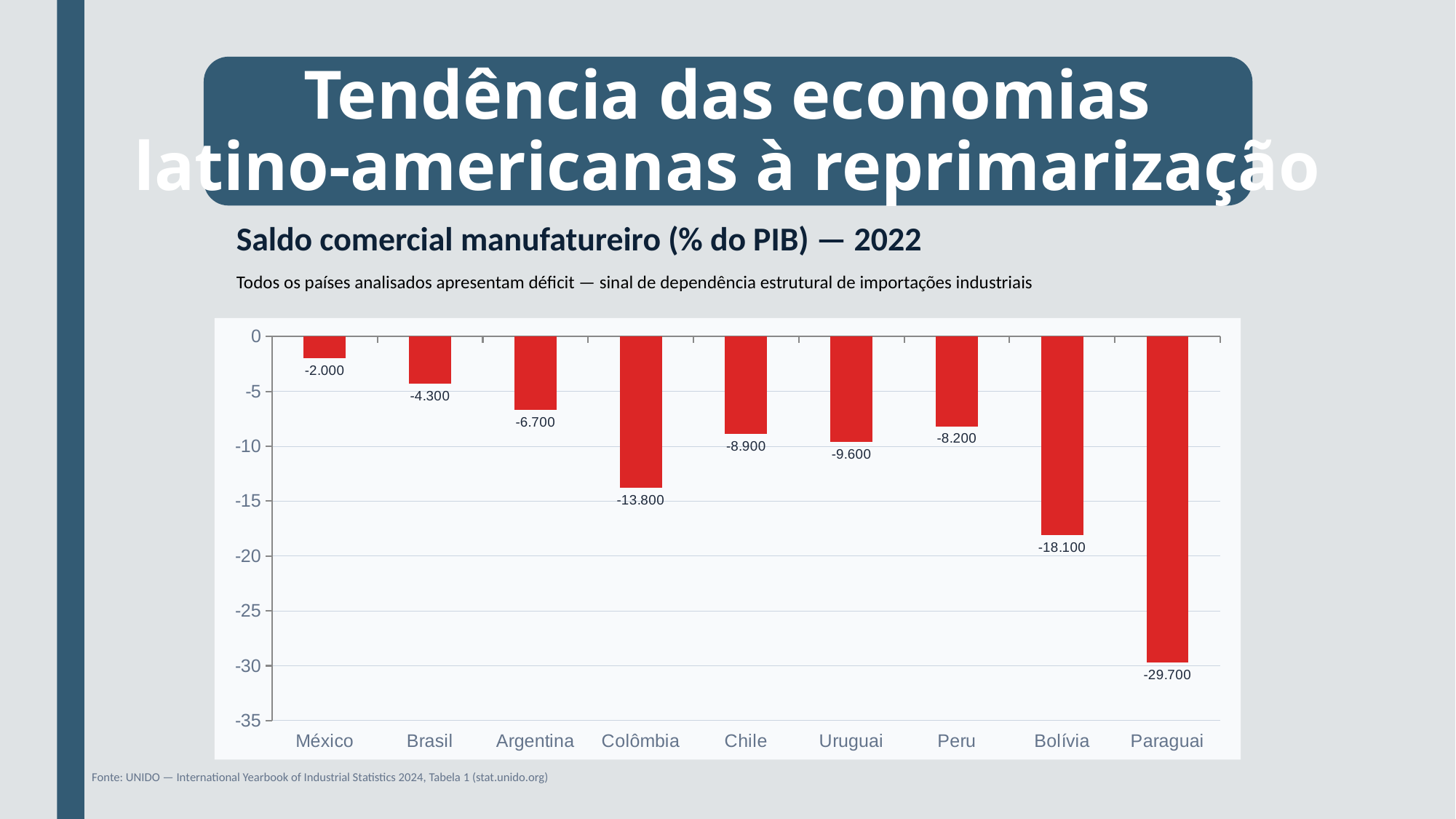
Which country has the highest value (smallest deficit)? México What is the value for Paraguai? -29.700 Which country has the lowest (most negative) value? Paraguai What is the difference between the values for Bolívia and Paraguai? 11.600 What kind of chart is shown on the slide? bar chart Is the value for Bolívia greater or less than -15? less What is the value for Uruguai? -9.600 What is the value for Colômbia? -13.800 Which has the larger deficit, Chile or Peru? Chile How many countries are shown in the chart? 9 What is the title of the chart? Saldo comercial manufatureiro (% do PIB) — 2022 What is the difference between the values for Colômbia and Argentina? 7.100